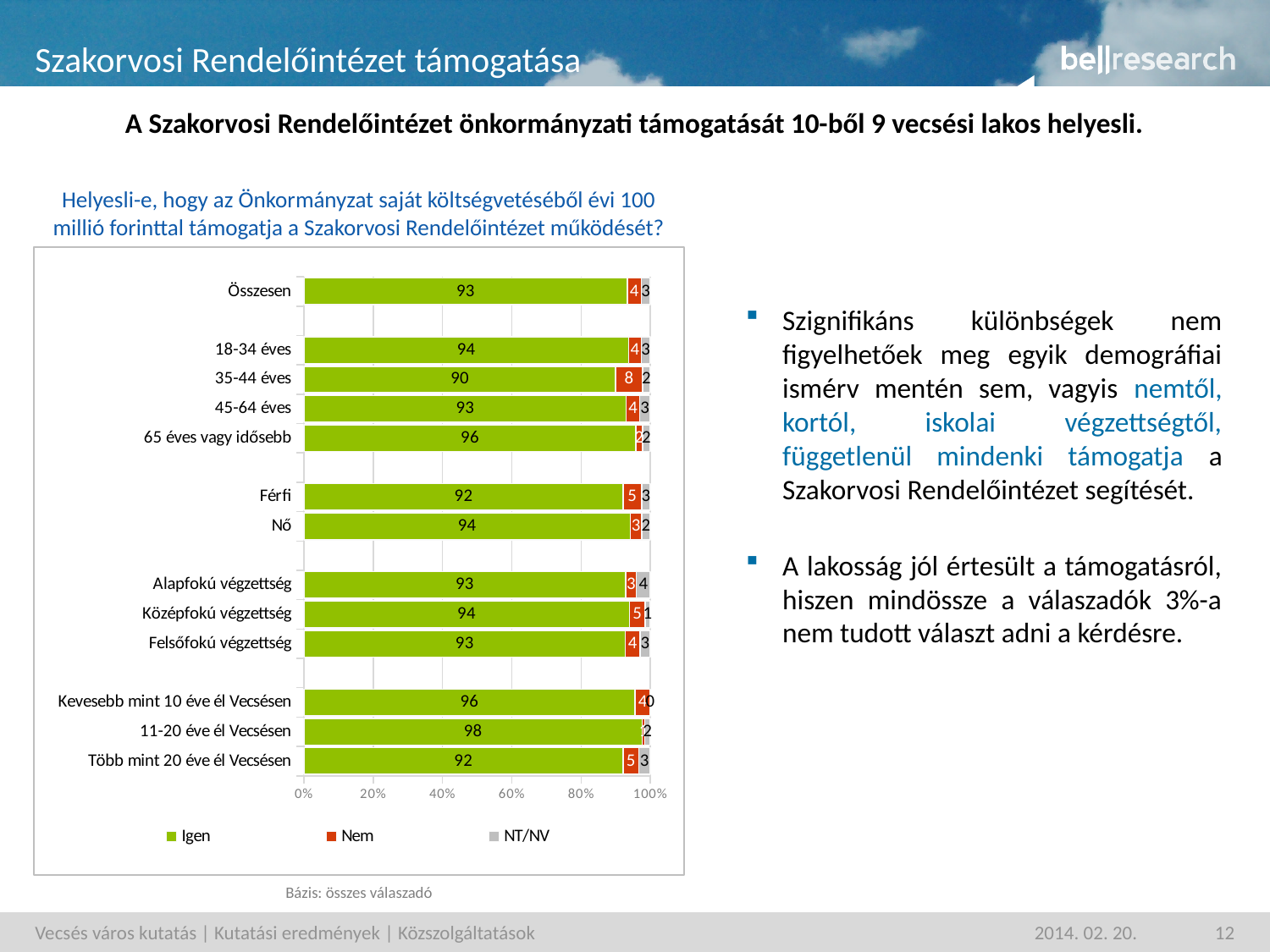
How many categories are shown on the chart? 13 Which category has the lowest Igen value? 35-44 éves What is the Igen value for Összesen? 93 Which series is shown in green in the legend? Igen How many series does the legend list? 3 What is the NT/NV value for Alapfokú végzettség? 4 What is the difference between the Igen values for 65 éves vagy idősebb and 35-44 éves? 6 What is the Nem value for 35-44 éves? 8 What is the Igen value for 11-20 éve él Vecsésen? 98 Which category has the highest Igen value? 11-20 éve él Vecsésen Which has a larger Igen value, Férfi or Nő? Nő What type of chart is shown on the slide? stacked bar chart